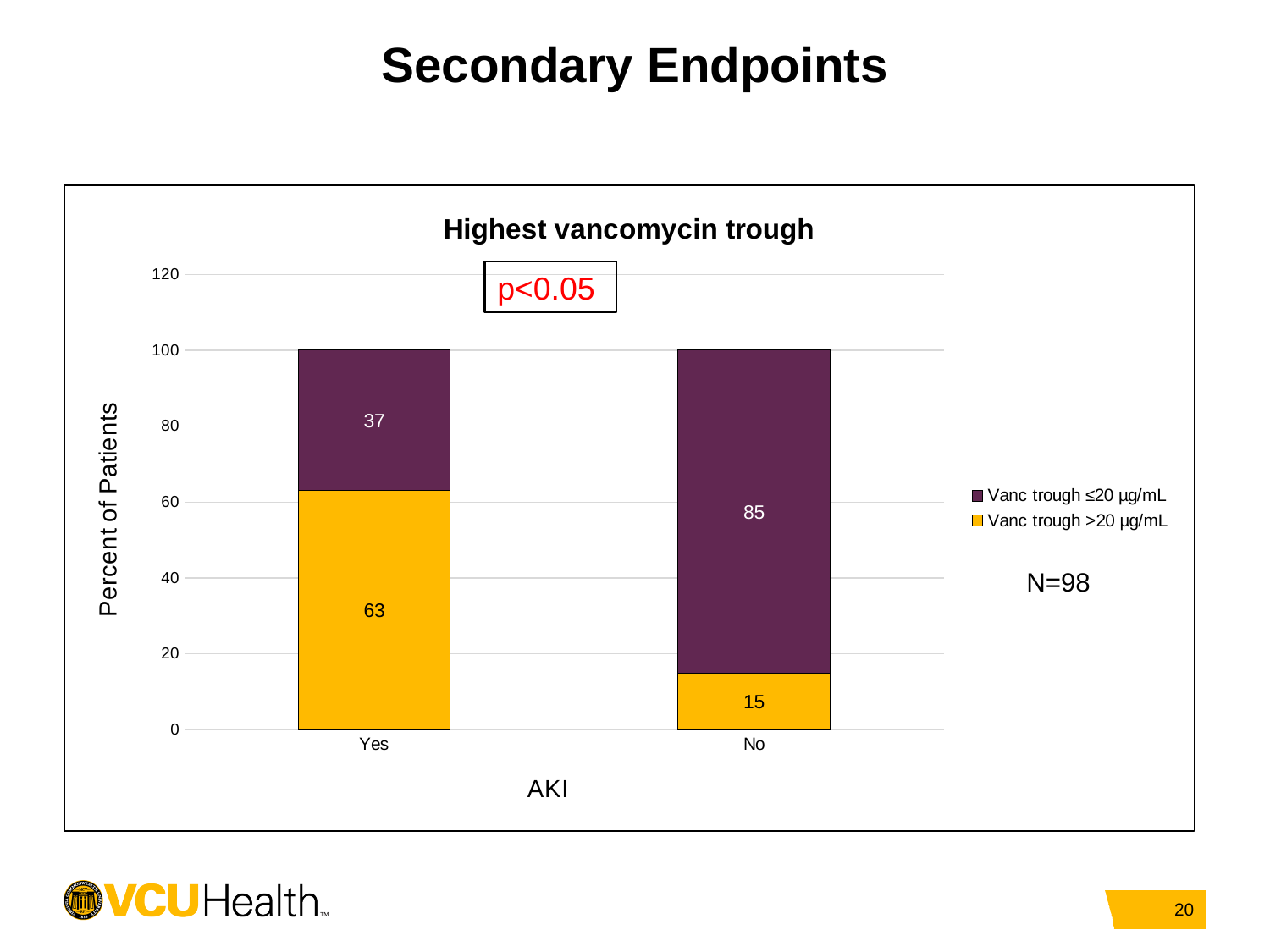
What kind of chart is shown on the slide? Stacked bar chart Is the 'Vanc trough ≤20 µg/mL' value larger for 'Yes' or for 'No'? No What is the value for 'Vanc trough ≤20 µg/mL' in the 'No' AKI category? 85 What is the value for 'Vanc trough ≤20 µg/mL' in the 'Yes' AKI category? 37 How many categories are shown on the x axis? 2 What is the difference between the 'Vanc trough >20 µg/mL' values for the 'Yes' and 'No' AKI categories? 48 Which AKI category has the higher value for 'Vanc trough >20 µg/mL'? Yes What is the value for 'Vanc trough >20 µg/mL' in the 'No' AKI category? 15 Which AKI category has the lower value for 'Vanc trough ≤20 µg/mL'? Yes How many series does the legend list? 2 What is the total of the stacked bar for the 'Yes' AKI category? 100 What is the value for 'Vanc trough >20 µg/mL' in the 'Yes' AKI category? 63